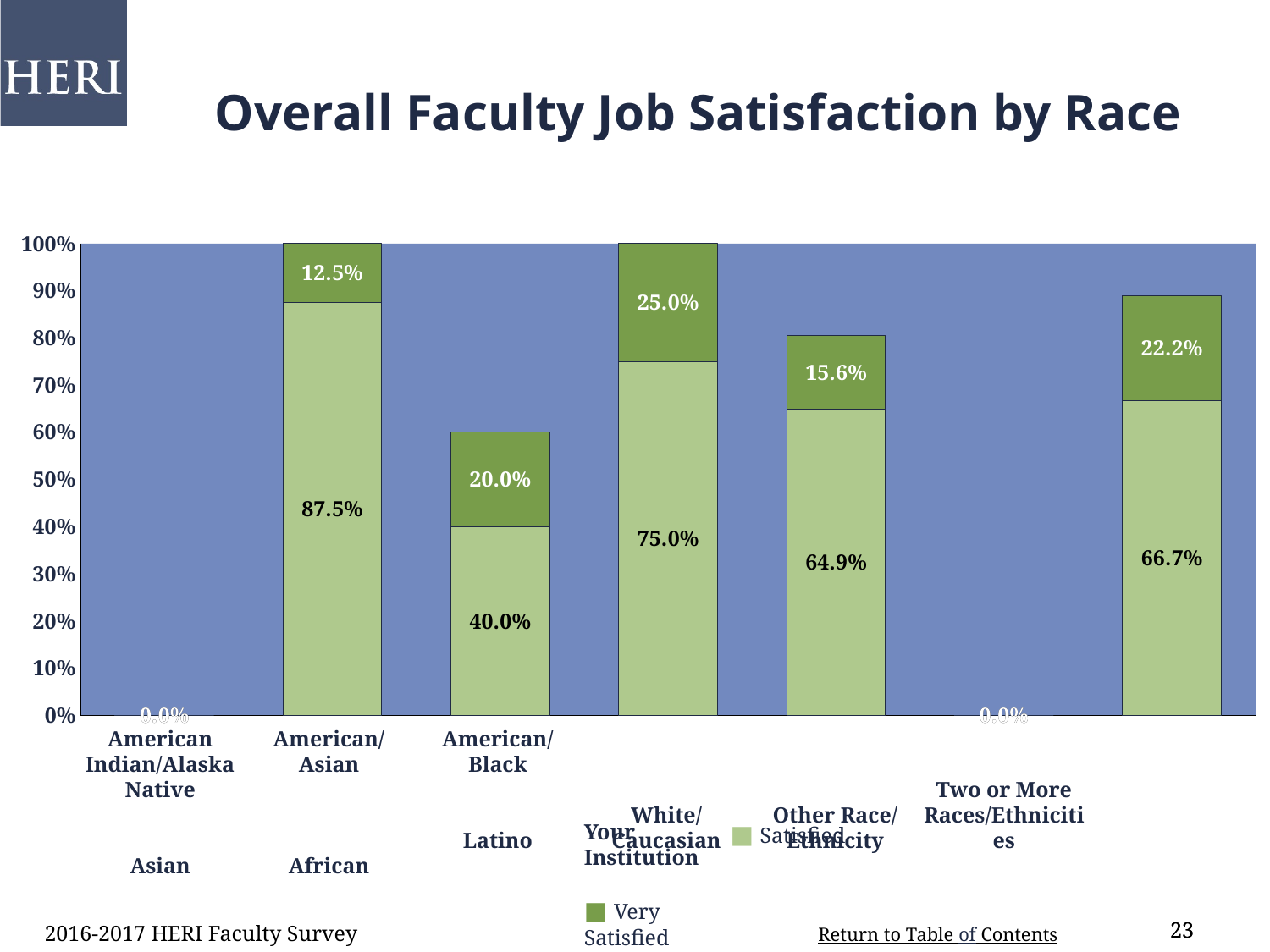
What is the Very Satisfied value for the rightmost bar? 22.2% What is the Satisfied value for the bar labelled American/Black? 40.0% What is the title of the chart? Overall Faculty Job Satisfaction by Race What is the total of the stacked bar labelled American/Black? 60.0% What is the total of the rightmost stacked bar? 88.9% What is the difference between the Satisfied values of the American/Asian bar and the American/Black bar? 47.5% What is the Very Satisfied value for the bar labelled American/Black? 20.0% Which bar has the highest Satisfied value? American/Asian How many series does the legend list? 2 What is the Satisfied value for the bar labelled American/Asian? 87.5% What is the Very Satisfied value for the bar labelled American/Asian? 12.5% What type of chart is shown on the slide? stacked bar chart